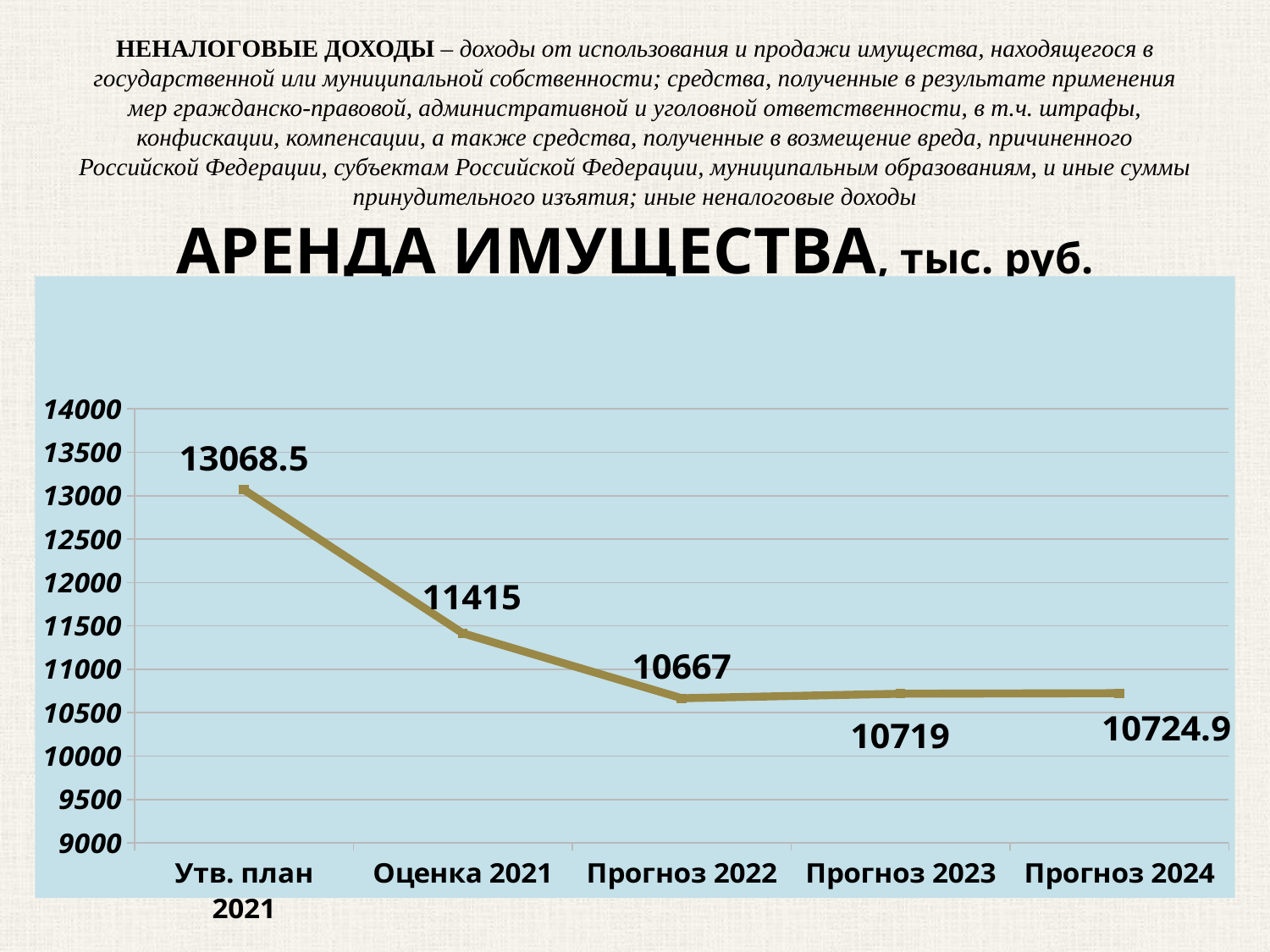
Which category has the lowest value? Прогноз 2022 What is the value for Прогноз 2024? 10724.9 Which category has the highest value? Утв. план 2021 What is the value for Оценка 2021? 11415 How many data points are plotted on the chart? 5 What kind of chart is shown on the slide? line chart What is the value for Утв. план 2021? 13068.5 What is the value for Прогноз 2022? 10667 What is the difference between the values for Утв. план 2021 and Оценка 2021? 1653.5 Which is larger, the value for Оценка 2021 or the value for Прогноз 2023? Оценка 2021 Is the value for Прогноз 2023 greater or less than 11000? less Do the values rise or fall from Утв. план 2021 to Прогноз 2022? fall